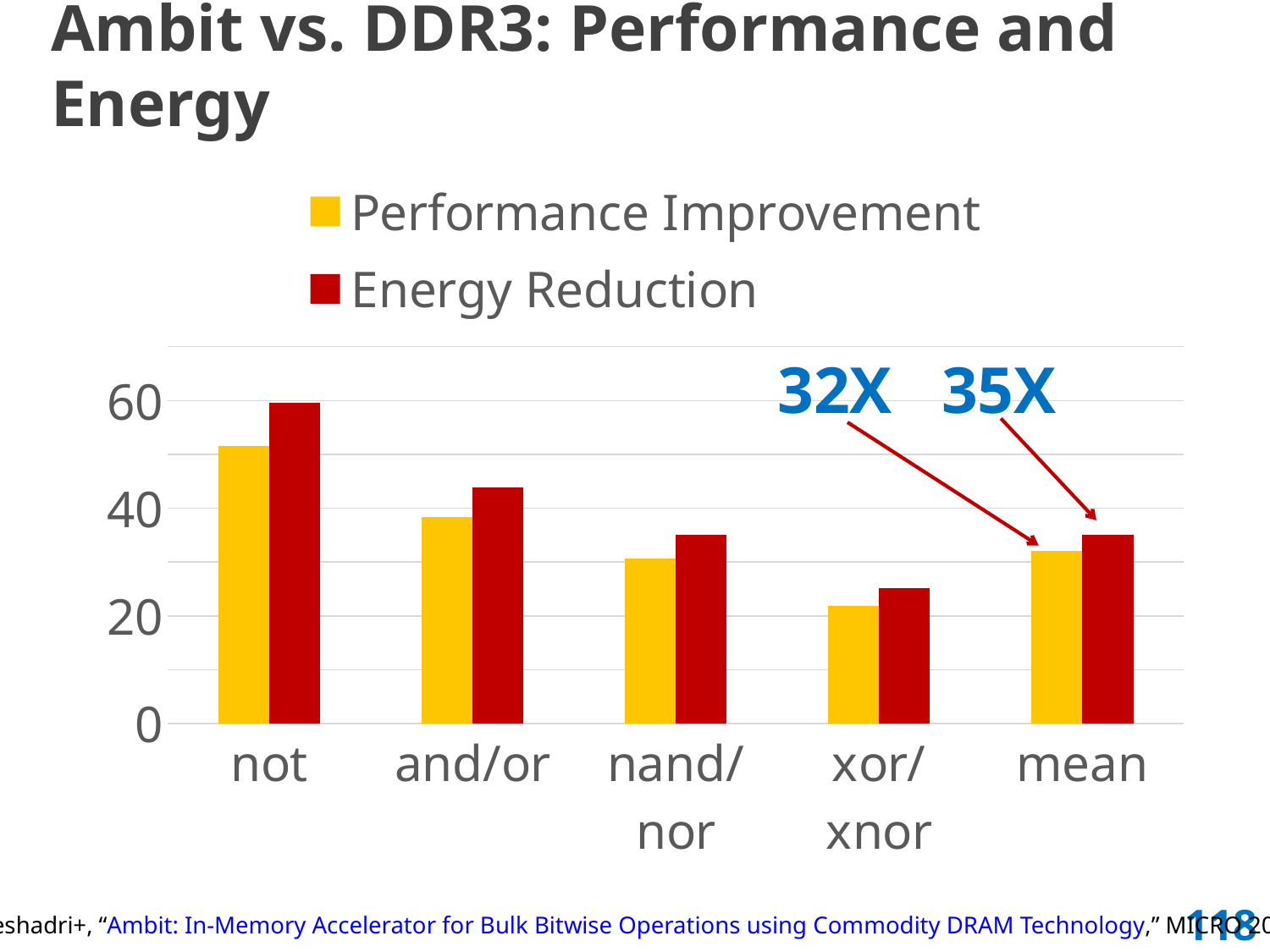
Which colour represents Energy Reduction in the legend? red Do the Performance Improvement values rise or fall from not to xor/xnor? fall What is the Performance Improvement value for mean? 32X What is the Energy Reduction value for mean? 35X How many categories are shown on the x axis? 5 Is the Energy Reduction for not greater or less than 40? greater Which is larger for and/or: Performance Improvement or Energy Reduction? Energy Reduction Is the Performance Improvement for xor/xnor greater or less than 40? less Which category has the lowest Performance Improvement? xor/xnor Which category has the highest Energy Reduction? not What kind of chart is shown on the slide? bar chart How many series does the legend list? 2